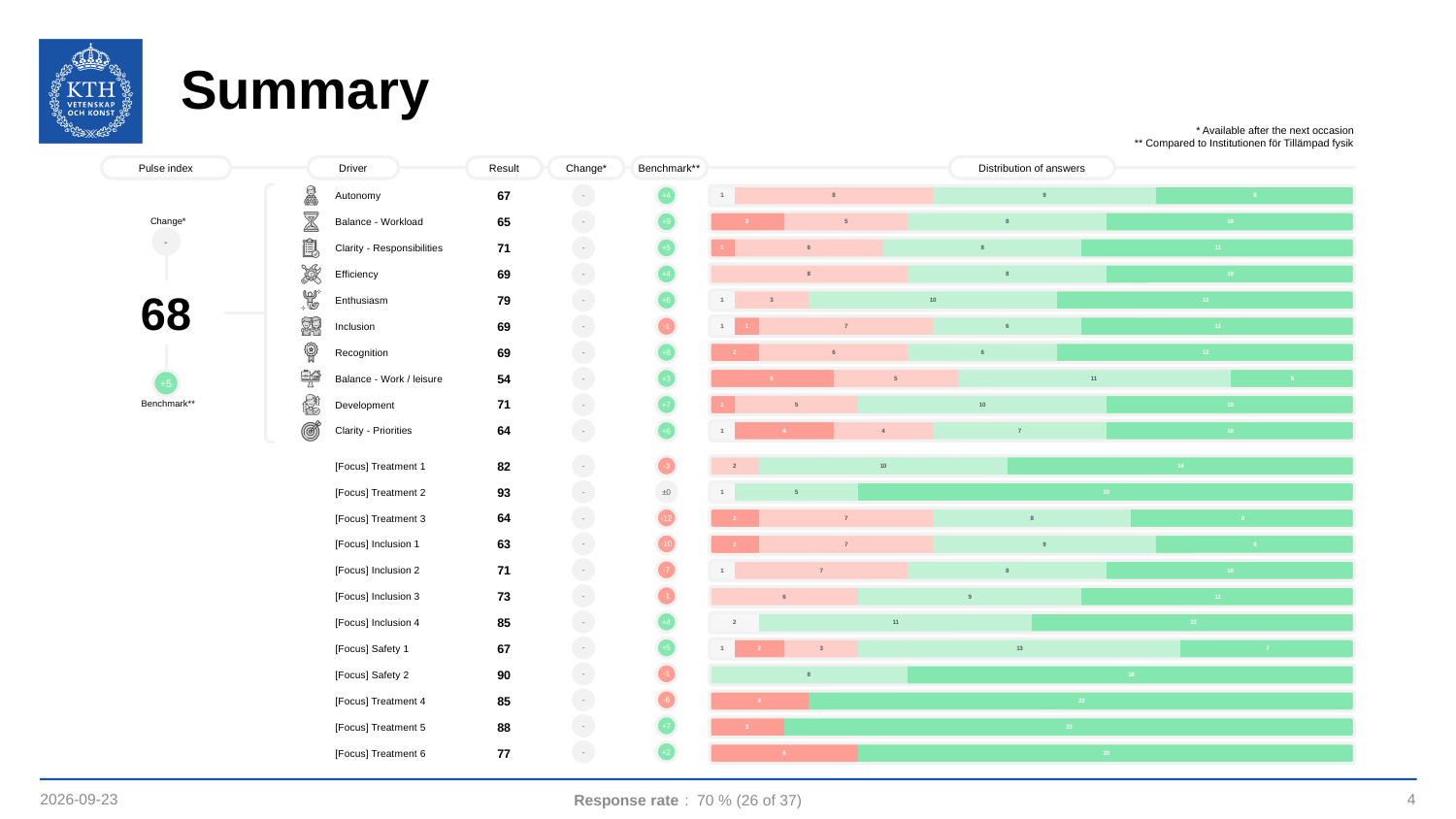
What is the Response rate shown at the bottom of the slide? 70 % (26 of 37) Which row has the lowest Result? Balance - Work / leisure How many driver rows are listed in the table (including the [Focus] rows)? 22 What is the overall Pulse index shown on the slide? 68 What kind of chart is used in the Distribution of answers column? Stacked bar chart What is the total number of answers in the Distribution of answers bar for [Focus] Treatment 4? 26 What is the Benchmark** value for [Focus] Treatment 3? -12 Which row has the highest Result? [Focus] Treatment 2 What is the difference between the Result for [Focus] Treatment 2 and the Result for [Focus] Treatment 3? 29 What is the Benchmark** value for Balance - Workload? +9 Which has a higher Result, Development or Autonomy? Development What is the Result for the Enthusiasm driver? 79